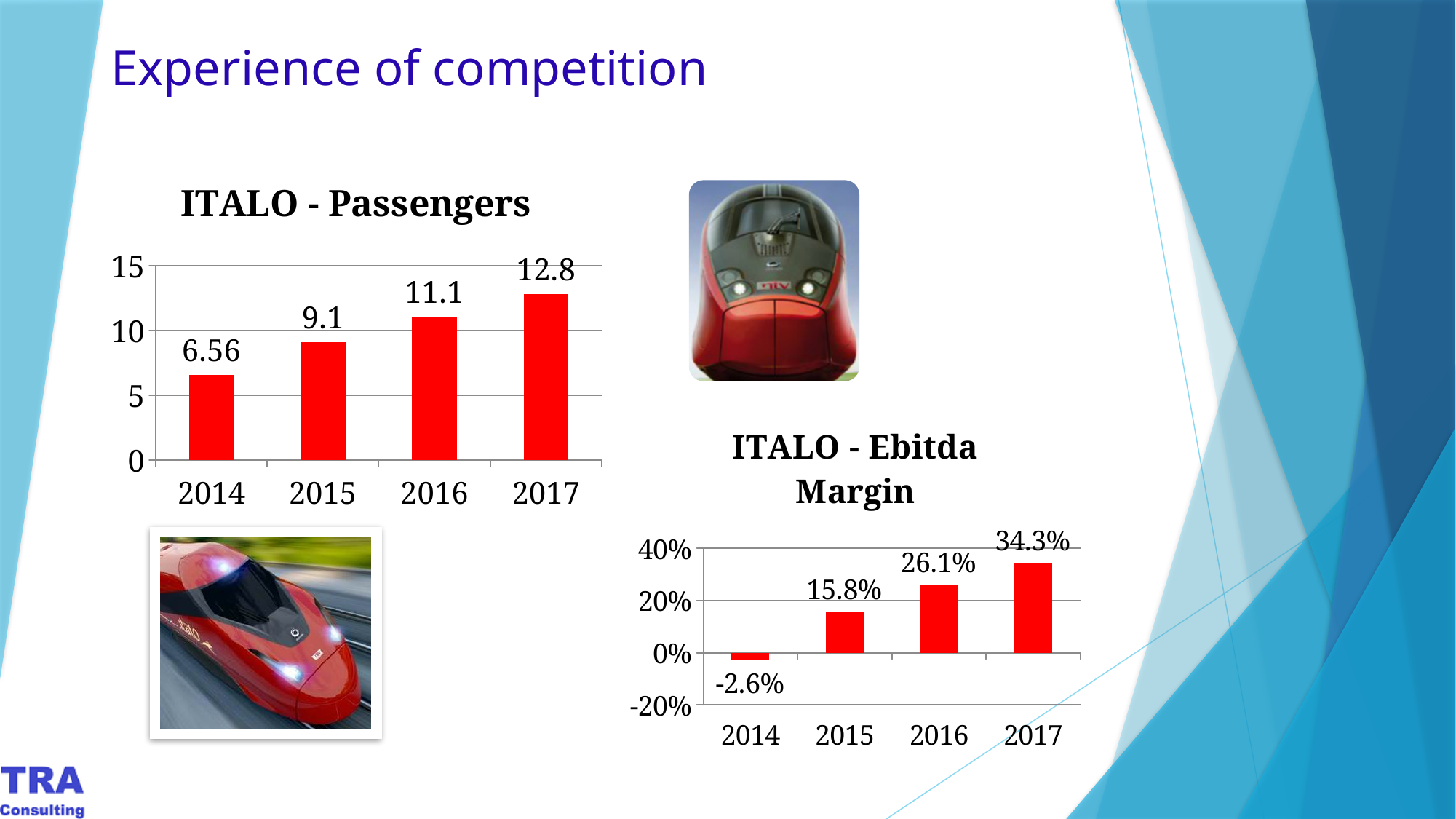
What kind of chart is the 'ITALO - Ebitda Margin' chart? bar chart In the 'ITALO - Ebitda Margin' chart, which year has the lowest value? 2014 In the 'ITALO - Passengers' chart, what is the value for 2016? 11.1 In the 'ITALO - Ebitda Margin' chart, what is the value for 2014? -2.6% In the 'ITALO - Ebitda Margin' chart, which is larger, the value for 2015 or the value for 2016? 2016 In the 'ITALO - Passengers' chart, how many years are shown? 4 In the 'ITALO - Ebitda Margin' chart, what is the value for 2017? 34.3% In the 'ITALO - Passengers' chart, what is the value for 2014? 6.56 In the 'ITALO - Passengers' chart, what is the difference between the 2017 and 2015 values? 3.7 In the 'ITALO - Passengers' chart, do the values rise or fall from 2014 to 2017? rise In the 'ITALO - Passengers' chart, which year has the highest value? 2017 In the 'ITALO - Ebitda Margin' chart, what is the difference between the 2016 and 2015 values? 10.3%